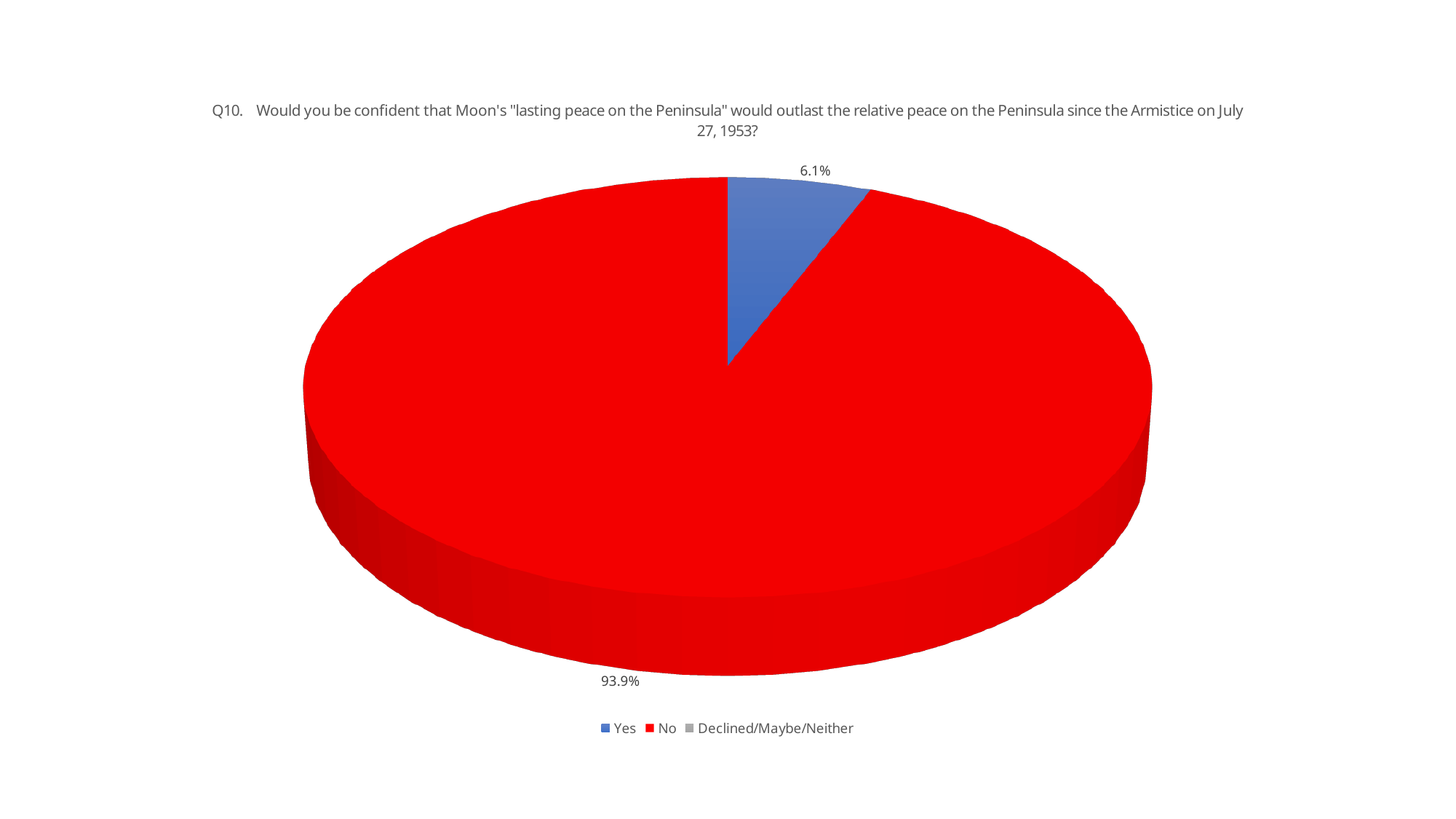
What share of the pie does the "Yes" slice represent? 6.1% What kind of chart is shown on the slide? pie chart Which category has the largest slice of the pie? No Which is larger, the share for Yes or the share for No? No Which of the two visible slices is smaller, Yes or No? Yes What is the difference in percentage points between the No share and the Yes share? 87.8 How many entries does the legend list? 3 What share of the pie does the "No" slice represent? 93.9% Is the share for No greater or less than 90%? greater What colour is the "No" slice? red Is the share for Yes greater or less than 10%? less What colour is the "Yes" slice? blue